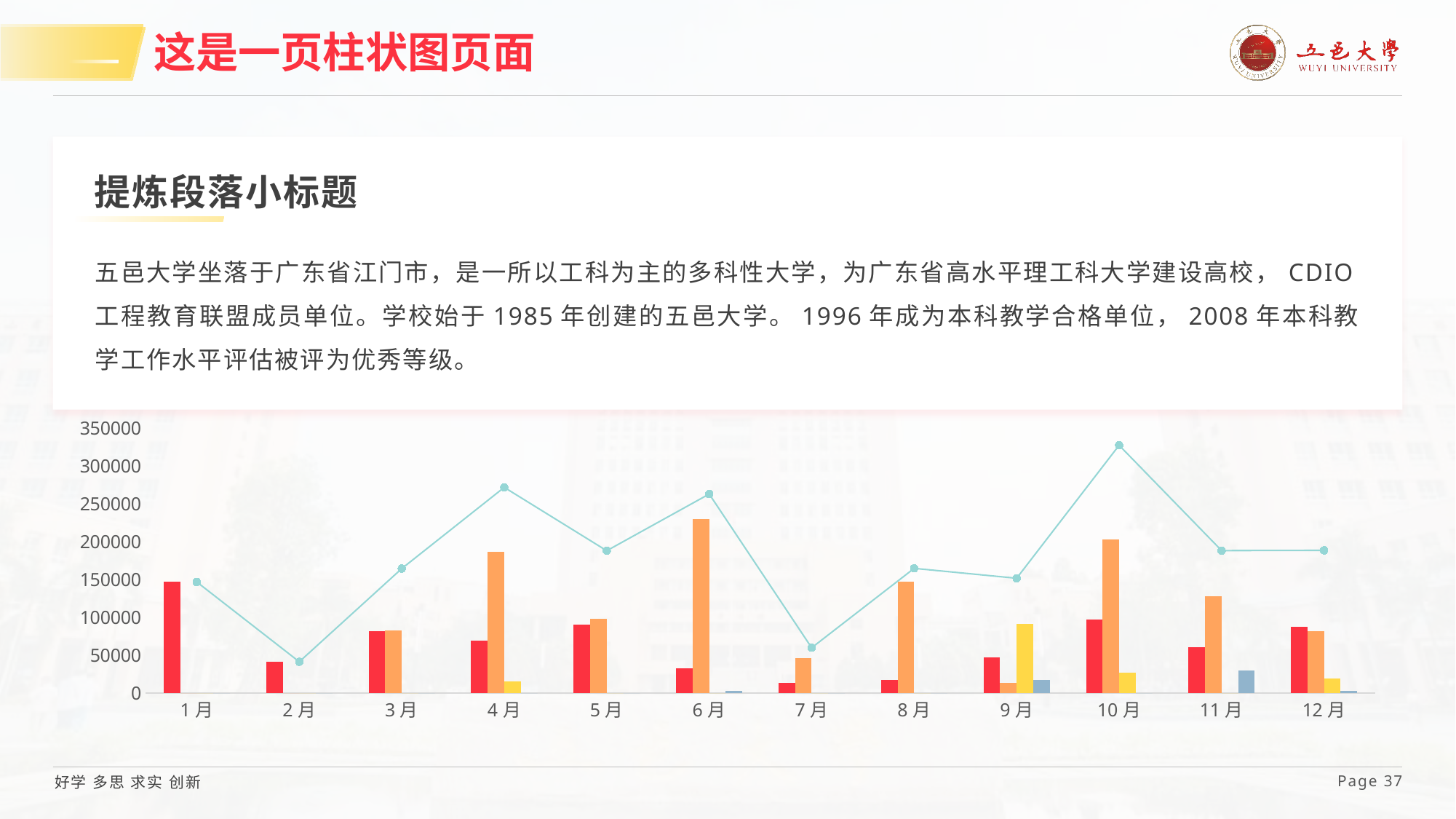
Which month has the tallest red bar? 1月 Is the value of the line series for 10月 greater or less than 300000? greater How many categories are shown on the x axis of the chart? 12 Is the value of the red bar for 1月 greater or less than 100000? greater Is the value of the line series for 2月 greater or less than 50000? less Which is larger, the red bar for 10月 or the red bar for 11月? 10月 In which month does the line series reach its lowest point? 2月 What kind of chart is shown on the slide? A bar chart combined with a line Does the line series rise or fall from 2月 to 4月? rise In which month does the line series reach its highest point? 10月 Which is larger, the orange bar for 4月 or the orange bar for 6月? 6月